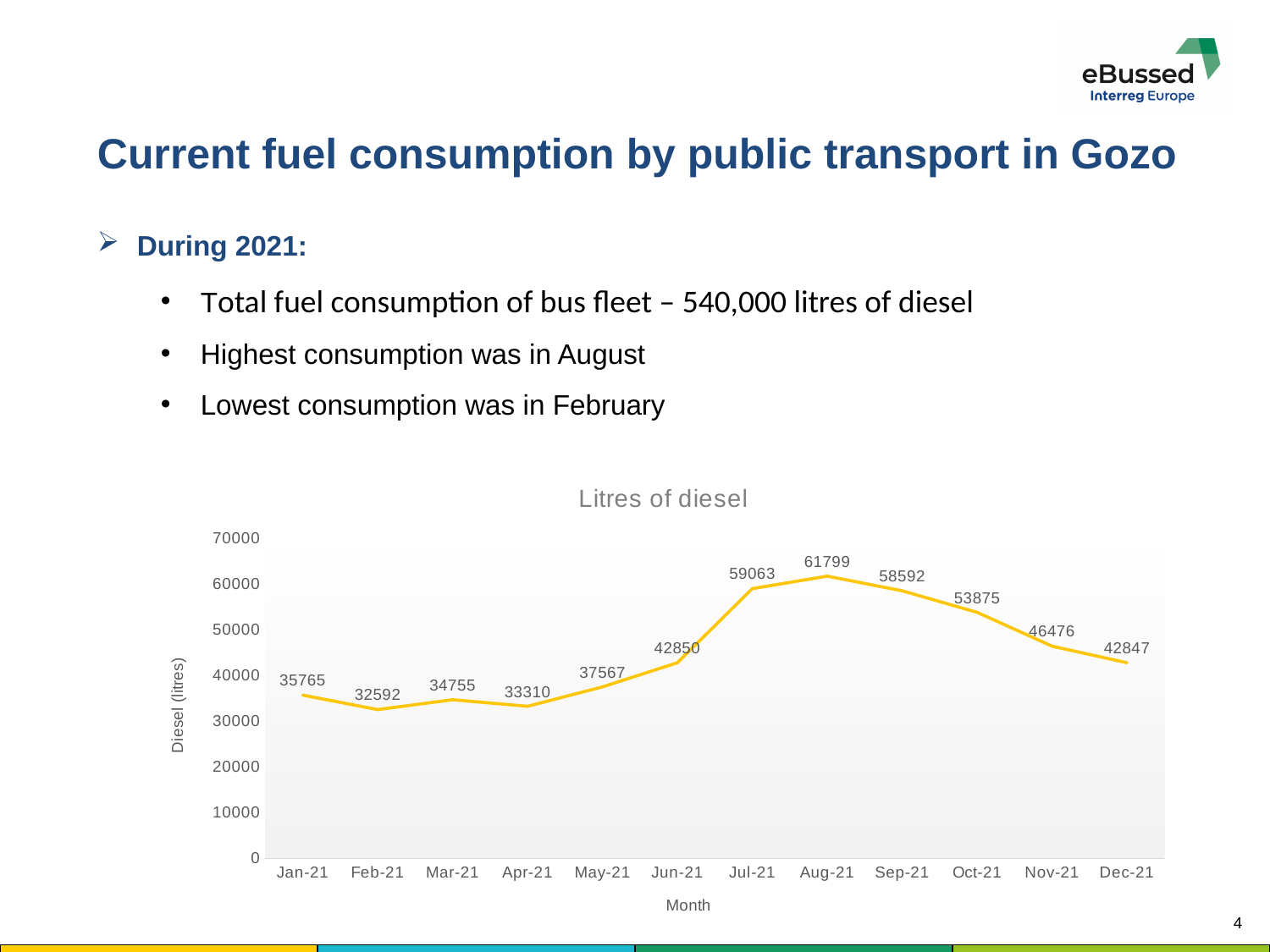
Which is larger, the value for Sep-21 or the value for Oct-21? Sep-21 What is the value for Aug-21 in the chart? 61799 What is the difference between the values for Aug-21 and Feb-21? 29207 Which month has the highest value in the chart? Aug-21 What is the title of the chart? Litres of diesel What kind of chart is shown on the slide? line chart What is the difference between the values for Jul-21 and Jun-21? 16213 How many months are plotted on the x axis of the chart? 12 What is the value for May-21 in the chart? 37567 Which month has the lowest value in the chart? Feb-21 What is the value for Feb-21 in the chart? 32592 Is the value for Nov-21 greater or less than 40000? greater